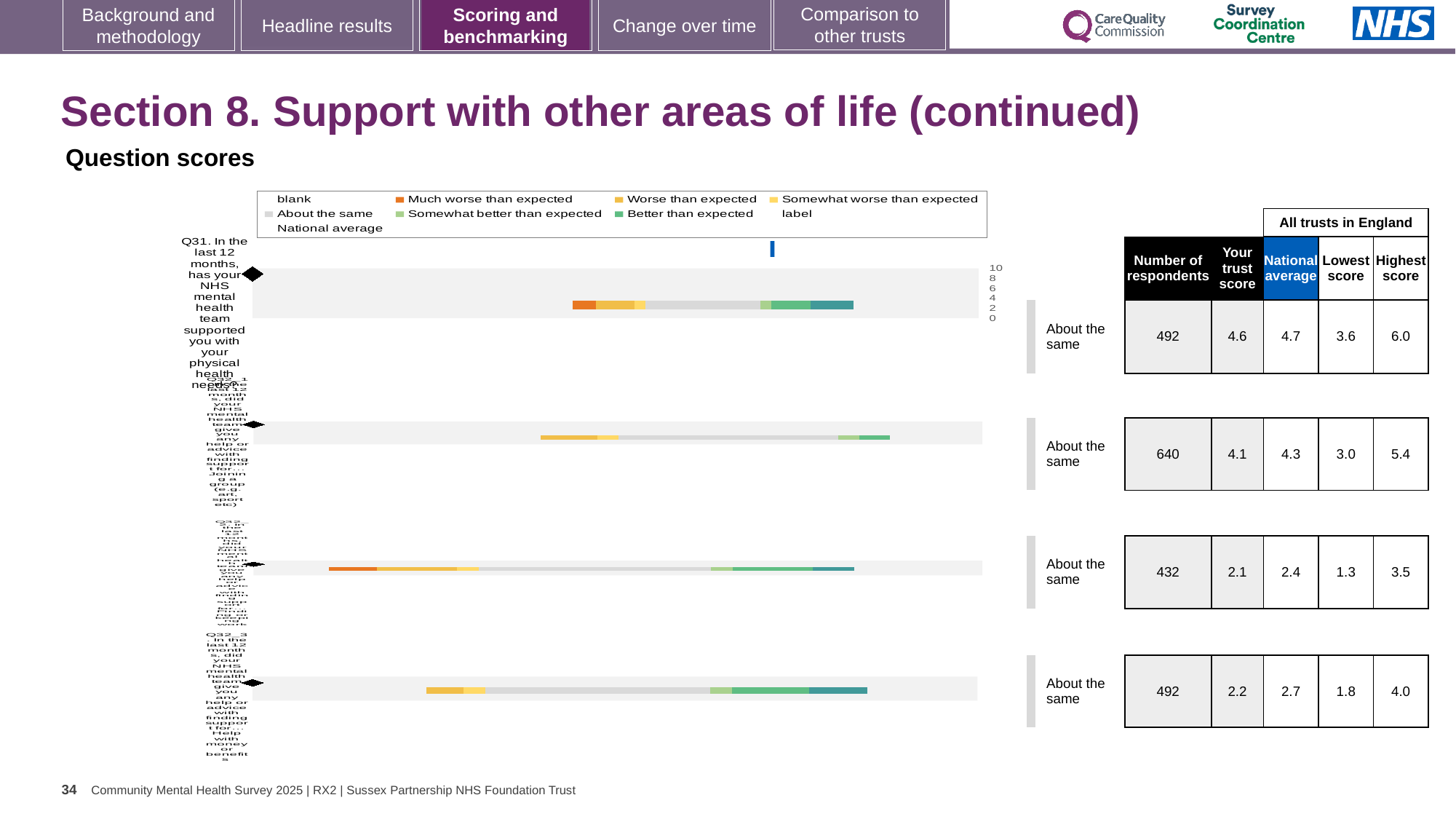
For the top chart (Q31), what is the trust score shown? 4.6 For the top chart (Q31), what is the difference between the national average and the trust score? 0.1 For the top chart (Q31), what is the national average shown? 4.7 Is the trust score for the top chart (Q31) greater or less than 4? greater In the chart legend, what colour represents "Much worse than expected"? orange What kind of chart is used to show the Q31 benchmarking result? bar chart What is the highest tick value on the axis of the top chart (Q31)? 10 How many benchmarking bar charts are shown on the slide? 4 Which of the four charts has the lowest trust score? the third chart (2.1) For the top chart (Q31), which is larger: the trust score or the national average? national average For the top chart (Q31), how many respondents are shown? 492 For the top chart (Q31), what benchmark category is shown next to the chart? About the same